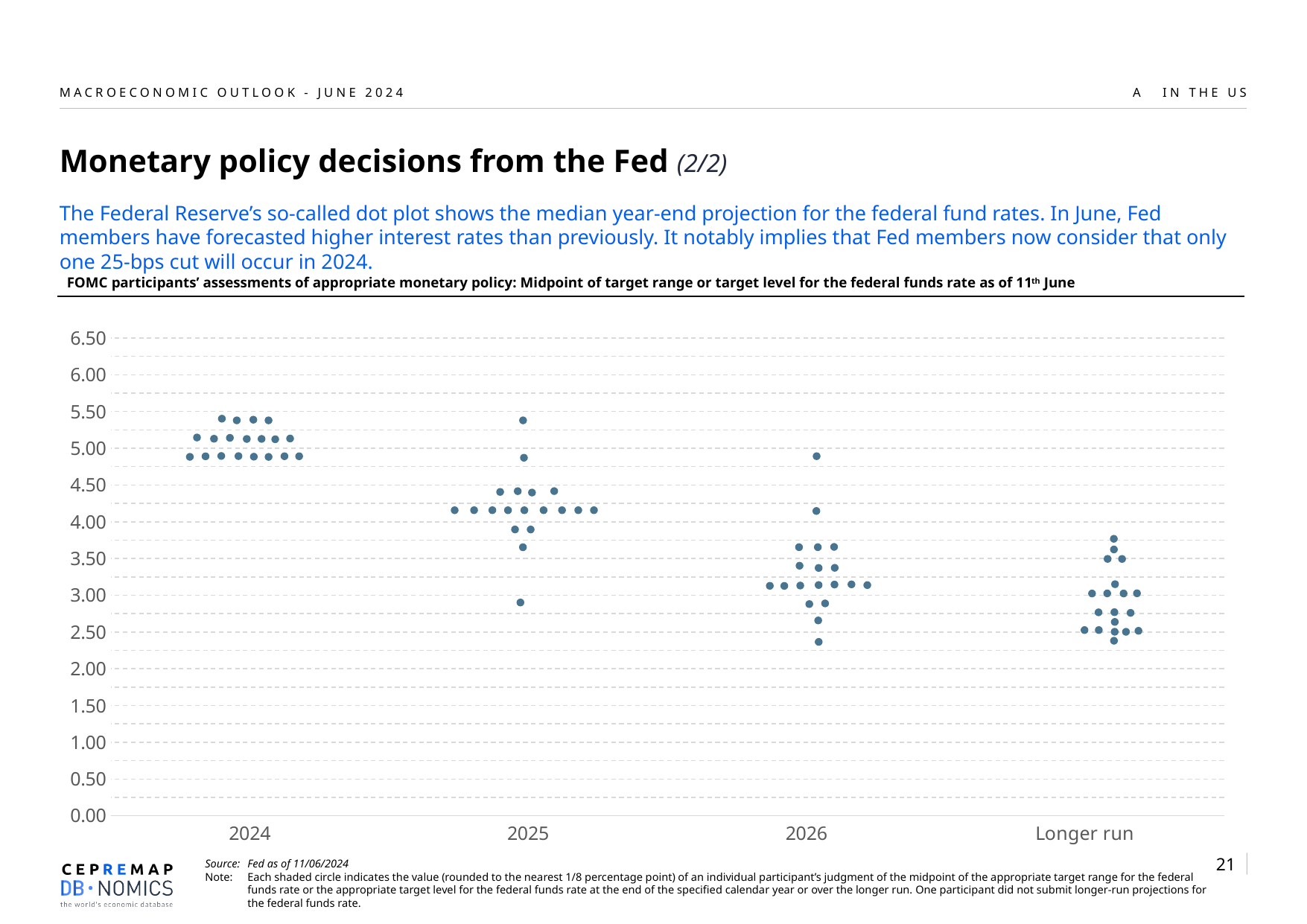
Is the highest dot for Longer run greater or less than 3.50? greater Is the lowest dot for 2026 greater or less than 3.00? less What kind of chart is shown on the slide? dot plot Which category on the x axis has the lowest projected federal funds rate dots? Longer run Which category has higher dots overall, 2025 or 2026? 2025 What is the highest value labelled on the y axis of the chart? 6.50 Are the dots for 2024 greater or less than 4.50? greater How many categories are shown along the x axis of the dot plot? 4 Which category on the x axis has the highest projected federal funds rate dots? 2024 Do the projected federal funds rate dots rise or fall moving from 2024 to Longer run along the x axis? fall